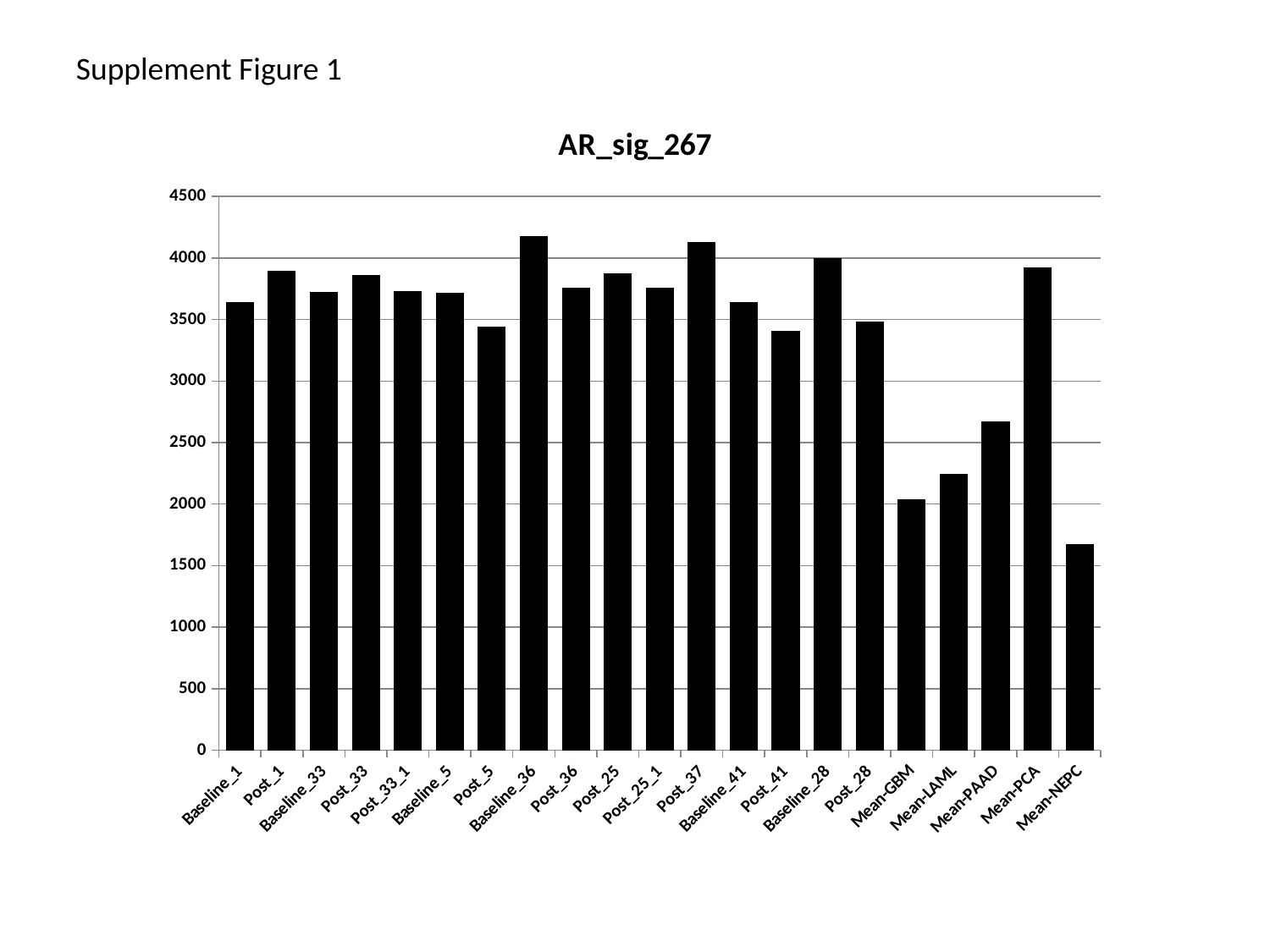
Which is larger, the value for Mean-GBM or the value for Mean-LAML? Mean-LAML Is the value for Mean-PAAD greater or less than 2500? greater Is the value for Baseline_36 greater or less than 4000? greater Is the value for Mean-LAML greater or less than 2500? less Which is larger, the value for Post_1 or the value for Baseline_1? Post_1 What kind of chart is shown on the slide? bar chart Which category has the lowest value? Mean-NEPC Which is larger, the value for Mean-PCA or the value for Mean-PAAD? Mean-PCA How many categories are plotted along the x axis? 21 What is the title of the chart? AR_sig_267